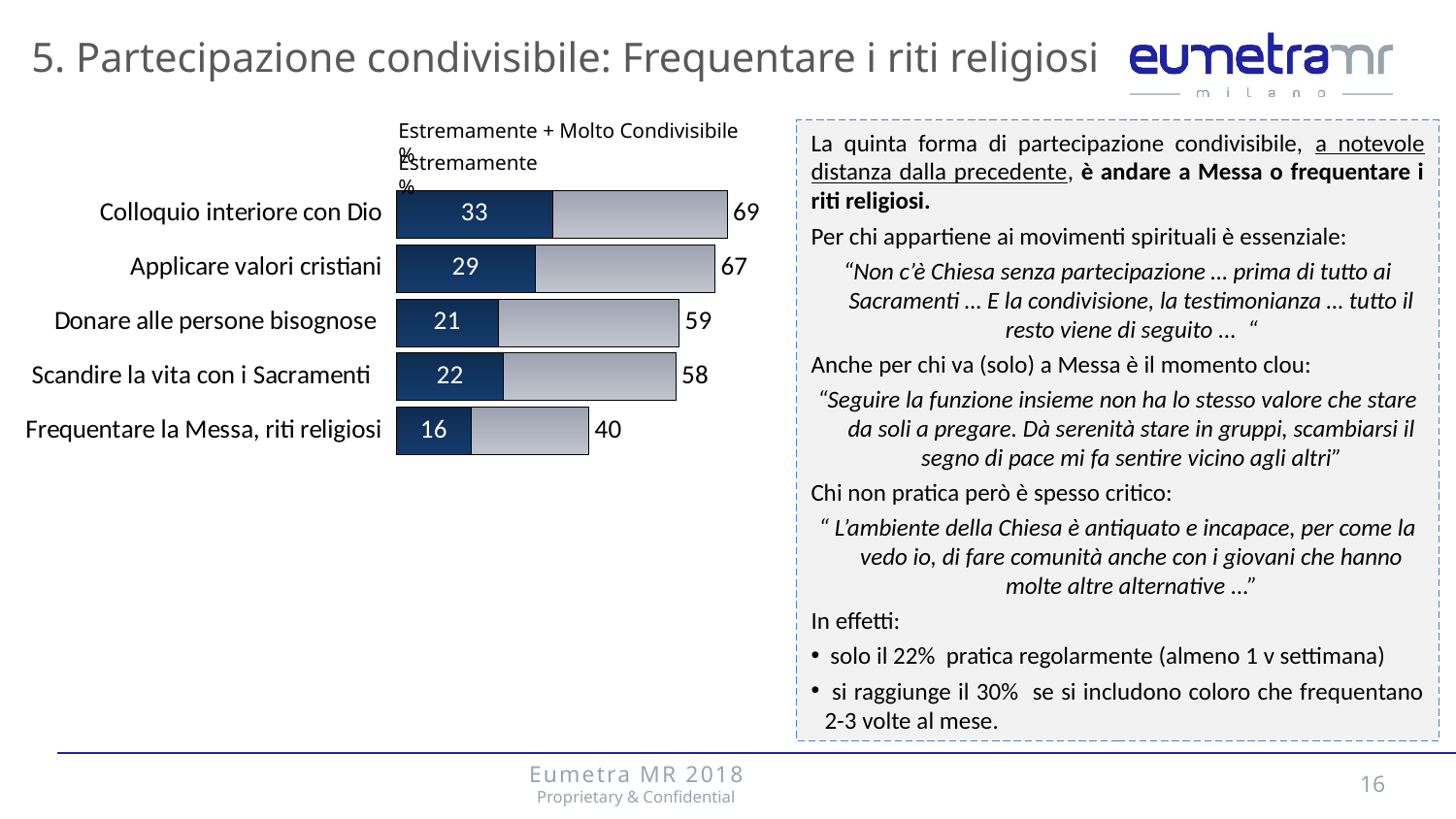
How many categories are shown in the chart? 5 Which has a larger 'Estremamente + Molto Condivisibile %' value: 'Donare alle persone bisognose' or 'Frequentare la Messa, riti religiosi'? Donare alle persone bisognose What is the 'Estremamente %' value for 'Frequentare la Messa, riti religiosi'? 16 What is the 'Estremamente %' value for 'Applicare valori cristiani'? 29 Which category has the highest 'Estremamente + Molto Condivisibile %' value? Colloquio interiore con Dio What is the difference between the 'Estremamente %' values for 'Scandire la vita con i Sacramenti' and 'Donare alle persone bisognose'? 1 What is the 'Estremamente + Molto Condivisibile %' value for 'Colloquio interiore con Dio'? 69 What type of chart is shown on the slide? Bar chart Which category has the lowest 'Estremamente %' value? Frequentare la Messa, riti religiosi What is the 'Estremamente + Molto Condivisibile %' value for 'Scandire la vita con i Sacramenti'? 58 What is the difference between the 'Estremamente + Molto Condivisibile %' values for 'Colloquio interiore con Dio' and 'Frequentare la Messa, riti religiosi'? 29